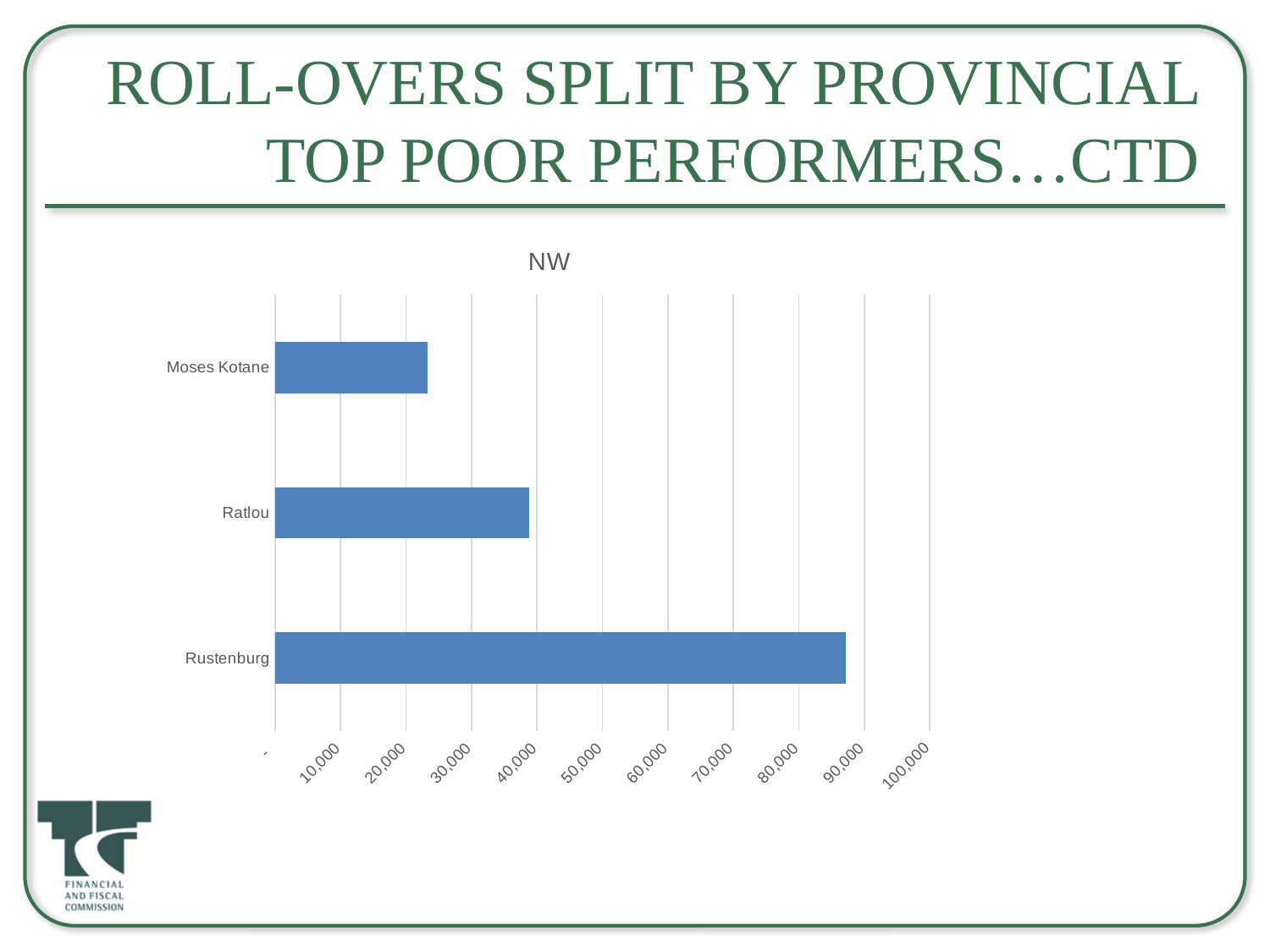
Is the value for Ratlou greater or less than 30,000? greater Is the value for Rustenburg greater or less than 90,000? less What is the title of the chart? NW Is the value for Moses Kotane greater or less than 30,000? less Which municipality has the lowest value in the chart? Moses Kotane Which has a larger value, Rustenburg or Ratlou? Rustenburg Which municipality has the highest value in the chart? Rustenburg What kind of chart is shown on the slide? bar chart How many municipalities are plotted in the chart? 3 What is the highest value shown on the horizontal axis of the chart? 100,000 Which has a larger value, Ratlou or Moses Kotane? Ratlou